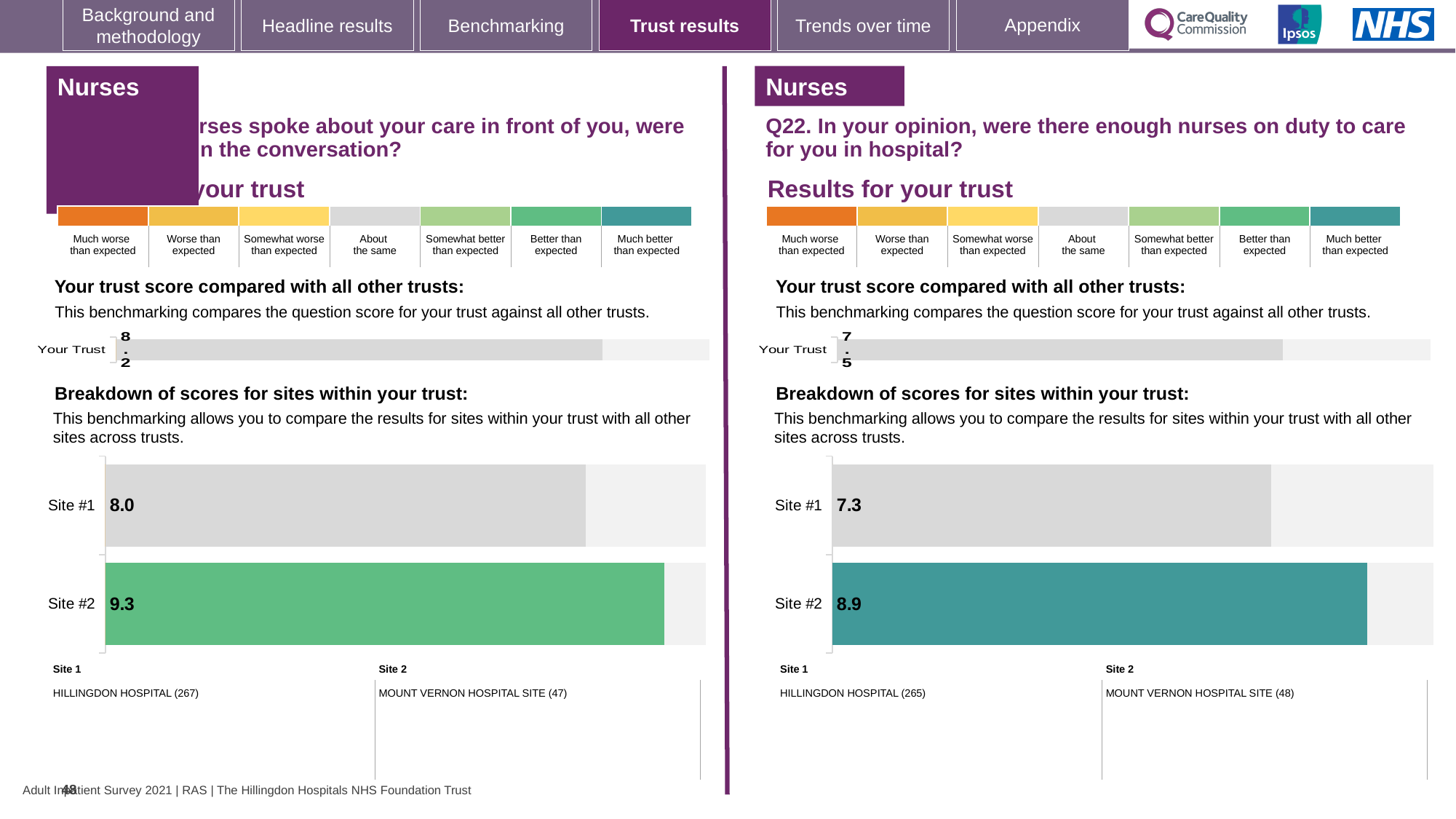
How many sites are shown in the right-hand Q22 site breakdown chart? 2 On the right-hand Q22 site breakdown chart, what is the difference between the Site #2 and Site #1 scores? 1.6 On the right-hand Q22 site breakdown chart, what is the score for Site #1? 7.3 What type of chart is used for the site breakdown on the right-hand Q22 section? Bar chart On the left-hand 'Your trust score compared with all other trusts' chart, what is the score for Your Trust? 8.2 On the left-hand site breakdown chart, what is the difference between the Site #2 and Site #1 scores? 1.3 On the right-hand Q22 'Your trust score compared with all other trusts' chart, what is the score for Your Trust? 7.5 On the left-hand site breakdown chart, what is the score for Site #1? 8.0 On the right-hand Q22 site breakdown chart, what is the score for Site #2? 8.9 On the left-hand site breakdown chart, which site has the lower score? Site #1 On the right-hand Q22 site breakdown chart, which site has the higher score? Site #2 On the left-hand site breakdown chart, what is the score for Site #2? 9.3